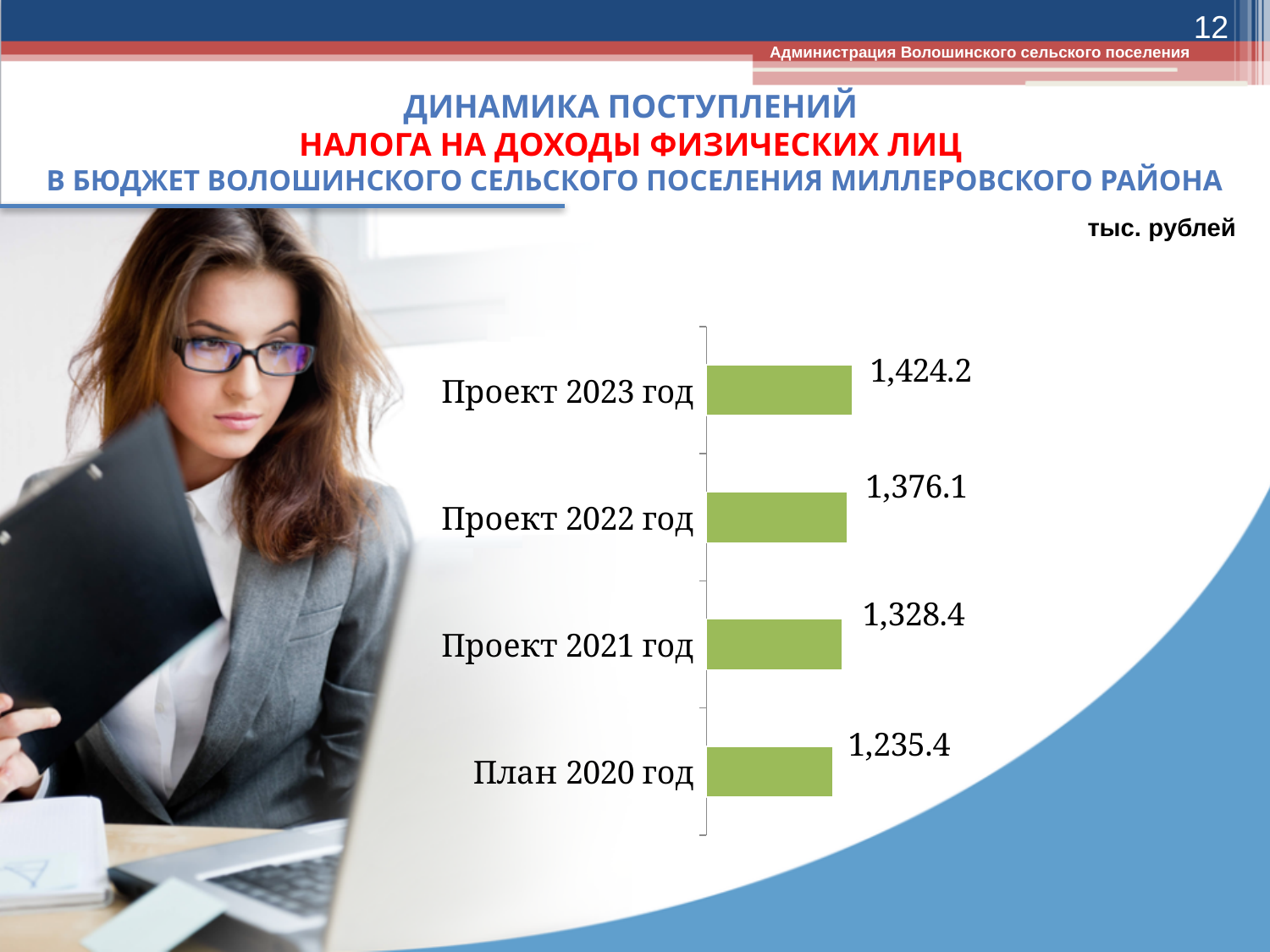
Which category has the lowest value? План 2020 год What is the value for Проект 2022 год? 1,376.1 What is the difference between the values for Проект 2023 год and Проект 2022 год? 48.1 How many categories are shown in the chart? 4 Which is larger, the value for Проект 2022 год or the value for Проект 2021 год? Проект 2022 год What kind of chart is shown on the slide? Bar chart What is the value for Проект 2023 год? 1,424.2 What is the value for Проект 2021 год? 1,328.4 What is the difference between the values for Проект 2021 год and План 2020 год? 93.0 What is the value for План 2020 год? 1,235.4 Do the values rise or fall from План 2020 год to Проект 2023 год? Rise Which category has the highest value? Проект 2023 год